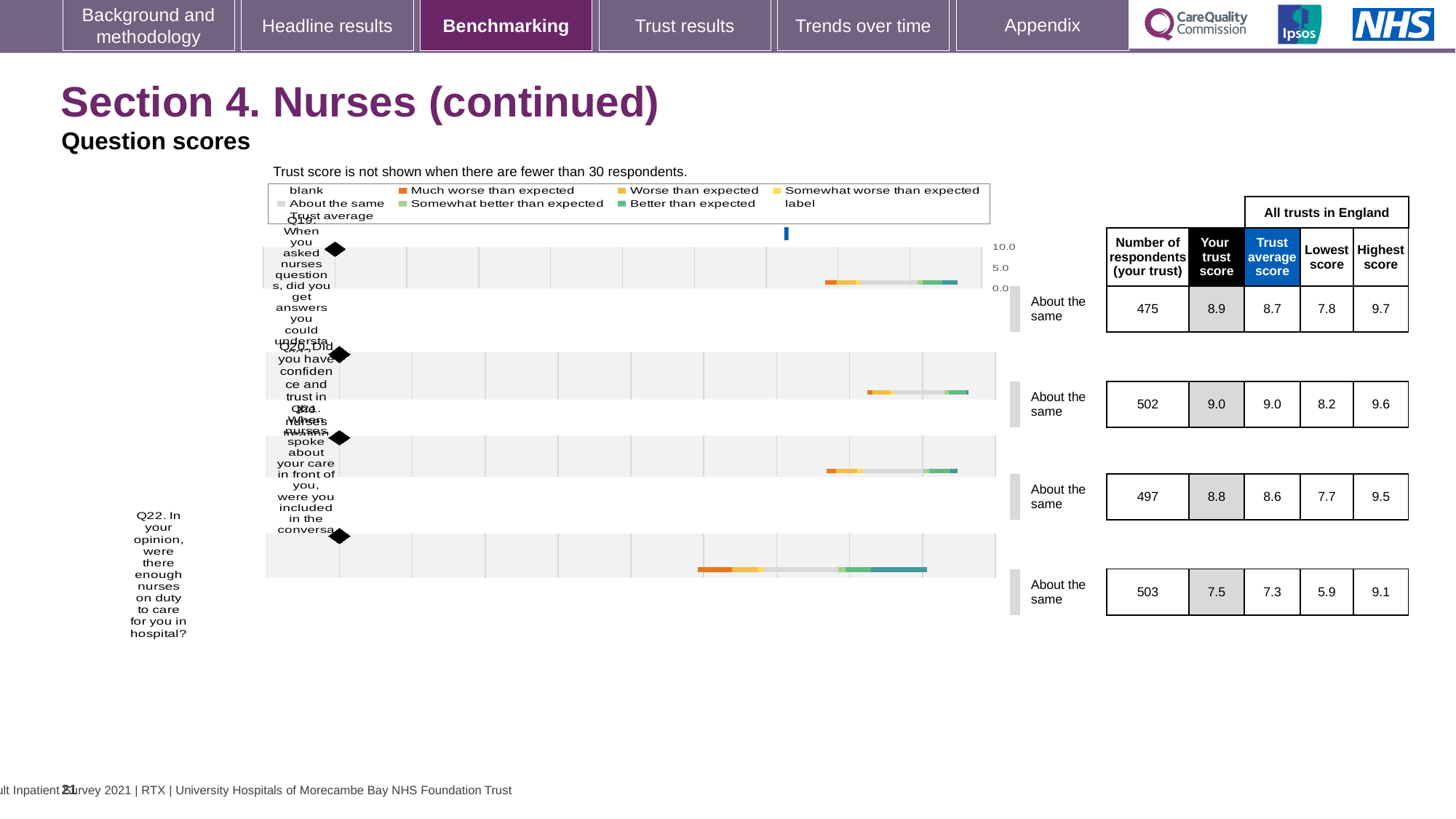
How many respondents are shown for Q20 (confidence and trust in nurses)? 502 Which question has the lowest 'Your trust score'? Q22 What benchmark category label is shown next to each of the four questions? About the same What kind of chart is used to show the question scores on this slide? bar chart What is the 'Highest score' across all trusts in England for Q22? 9.1 What is the 'Your trust score' value for Q22 (enough nurses on duty)? 7.5 What is the 'Lowest score' across all trusts in England for Q20? 8.2 How many questions (categories) are plotted in the chart? 4 What is the maximum value shown on the chart's score axis? 10.0 For Q21, which is larger: the 'Your trust score' or the 'Trust average score'? Your trust score Which question has the highest 'Your trust score'? Q20 What is the difference between the 'Your trust score' and the 'Trust average score' for Q19? 0.2